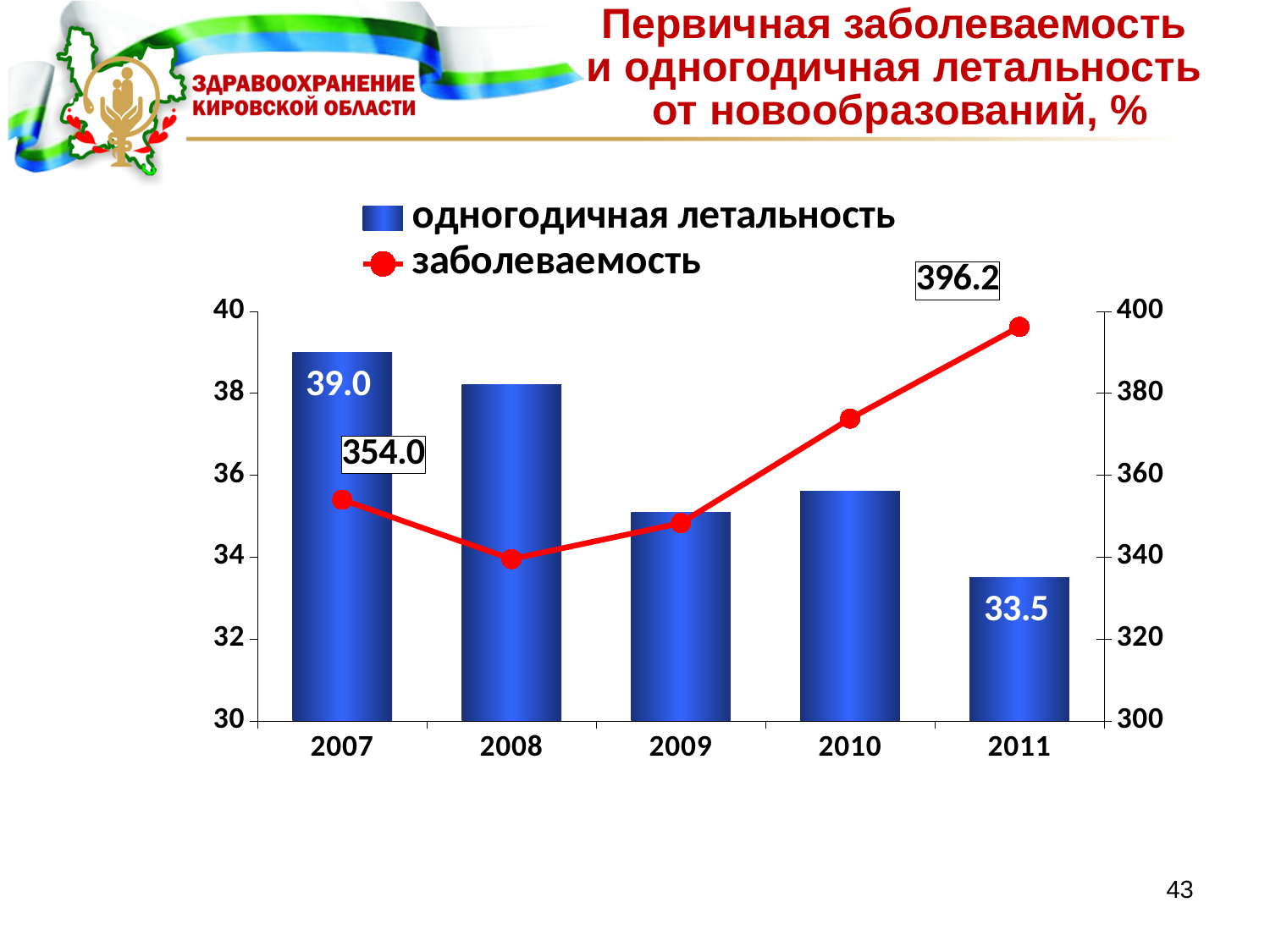
By how much did заболеваемость increase from 2007 to 2011? 42.2 Which year has the lowest заболеваемость? 2008 What is the value of одногодичная летальность for 2011? 33.5 What is the value of заболеваемость for 2007? 354.0 How many years are shown on the x axis? 5 Which is larger, одногодичная летальность in 2008 or in 2010? 2008 Is the value of заболеваемость for 2010 greater or less than 360? greater How many series does the legend list? 2 By how much did одногодичная летальность decrease from 2007 to 2011? 5.5 What is the value of заболеваемость for 2011? 396.2 What is the value of одногодичная летальность for 2007? 39.0 Which year has the highest одногодичная летальность? 2007